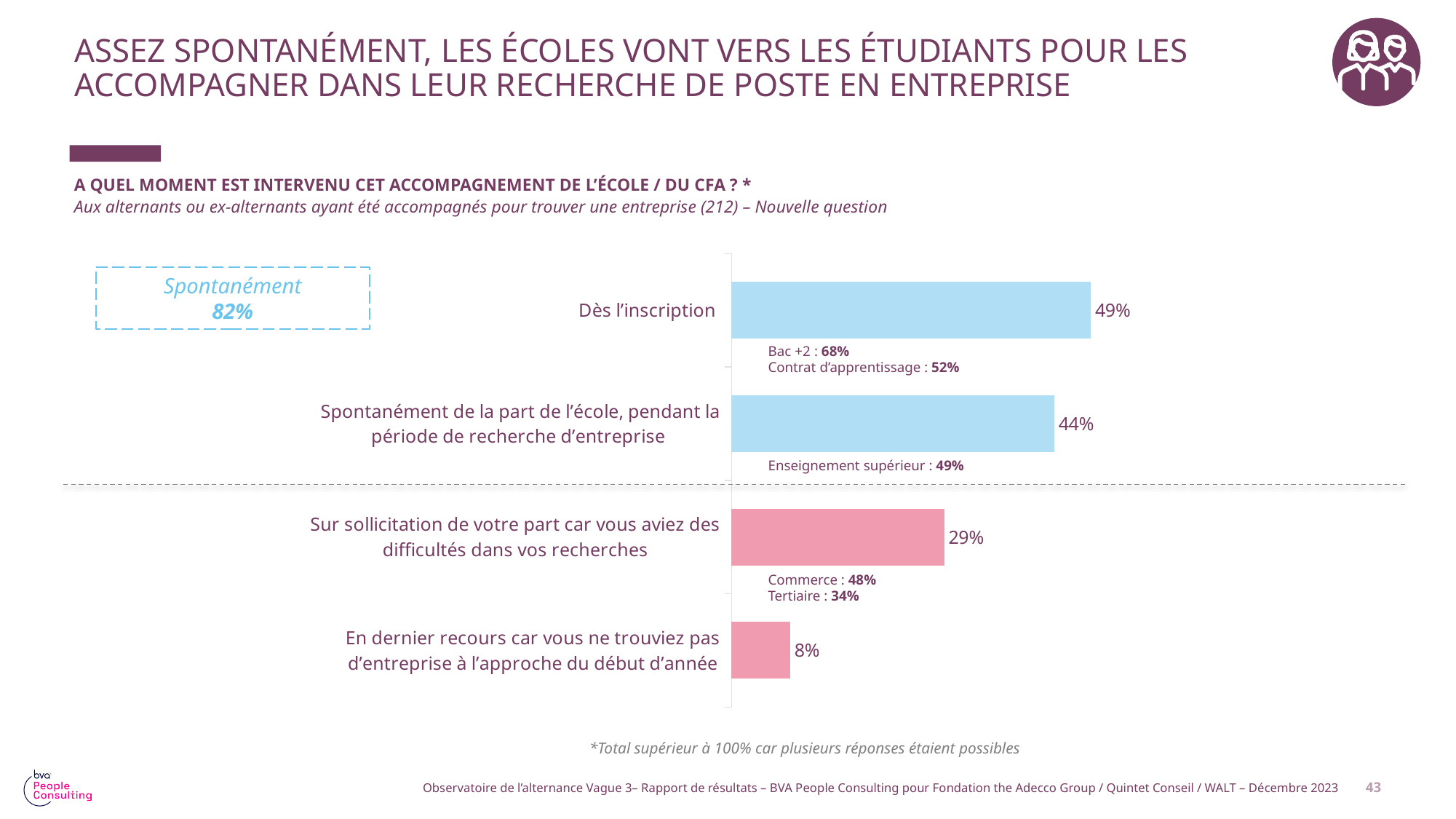
What is the value for "Spontanément de la part de l'école, pendant la période de recherche d'entreprise"? 44% What is the difference between the values for "Dès l'inscription" and "Sur sollicitation de votre part car vous aviez des difficultés dans vos recherches"? 20% What is the value for "Sur sollicitation de votre part car vous aviez des difficultés dans vos recherches"? 29% Which is larger: the value for "Spontanément de la part de l'école, pendant la période de recherche d'entreprise" or the value for "En dernier recours car vous ne trouviez pas d'entreprise à l'approche du début d'année"? Spontanément de la part de l'école, pendant la période de recherche d'entreprise What is the value for "En dernier recours car vous ne trouviez pas d'entreprise à l'approche du début d'année"? 8% How many categories are shown in the chart? 4 What percentage is shown in the dashed box labelled "Spontanément"? 82% What is the value for "Dès l'inscription" among Bac +2 respondents, as noted under the bar? 68% What is the value for "Dès l'inscription"? 49% Which category has the highest value? Dès l'inscription What kind of chart is shown on the slide? Bar chart Which category has the lowest value? En dernier recours car vous ne trouviez pas d'entreprise à l'approche du début d'année